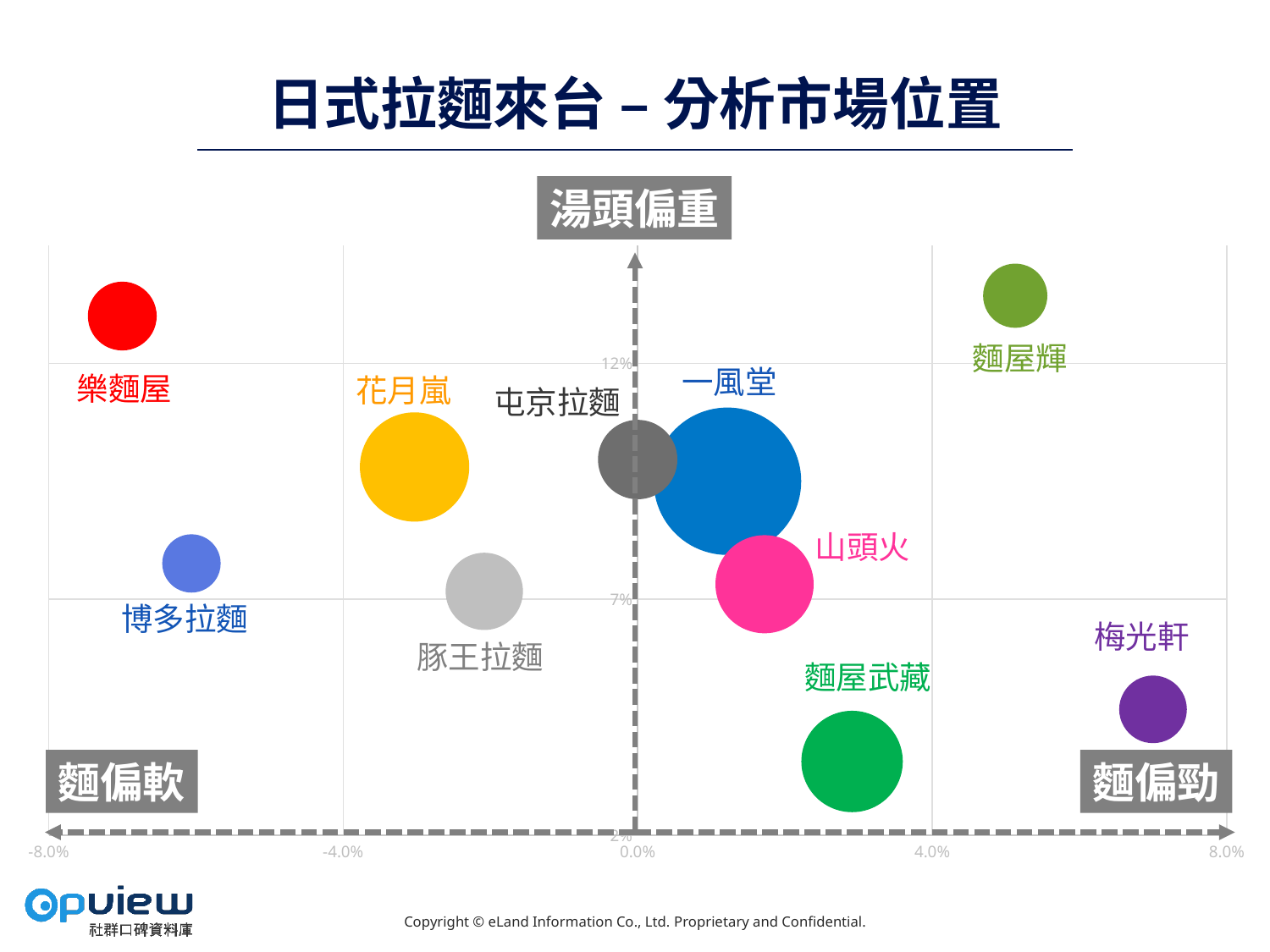
Is the vertical-axis value for 花月嵐 greater or less than 7%? greater Is the x-axis value for 博多拉麵 greater or less than -4.0%? less Which brand is positioned furthest to the left on the x axis? 樂麵屋 Is the x-axis value for 麵屋輝 greater or less than 4.0%? greater Which brand is positioned furthest to the right on the x axis? 梅光軒 Which brand has the largest bubble on the chart? 一風堂 Which brand is positioned lowest on the vertical axis? 麵屋武藏 Which brand is further to the right on the x axis, 山頭火 or 屯京拉麵? 山頭火 What kind of chart is shown on the slide? Bubble chart What is the title of the slide? 日式拉麵來台 – 分析市場位置 How many ramen brands (bubbles) are plotted on the chart? 10